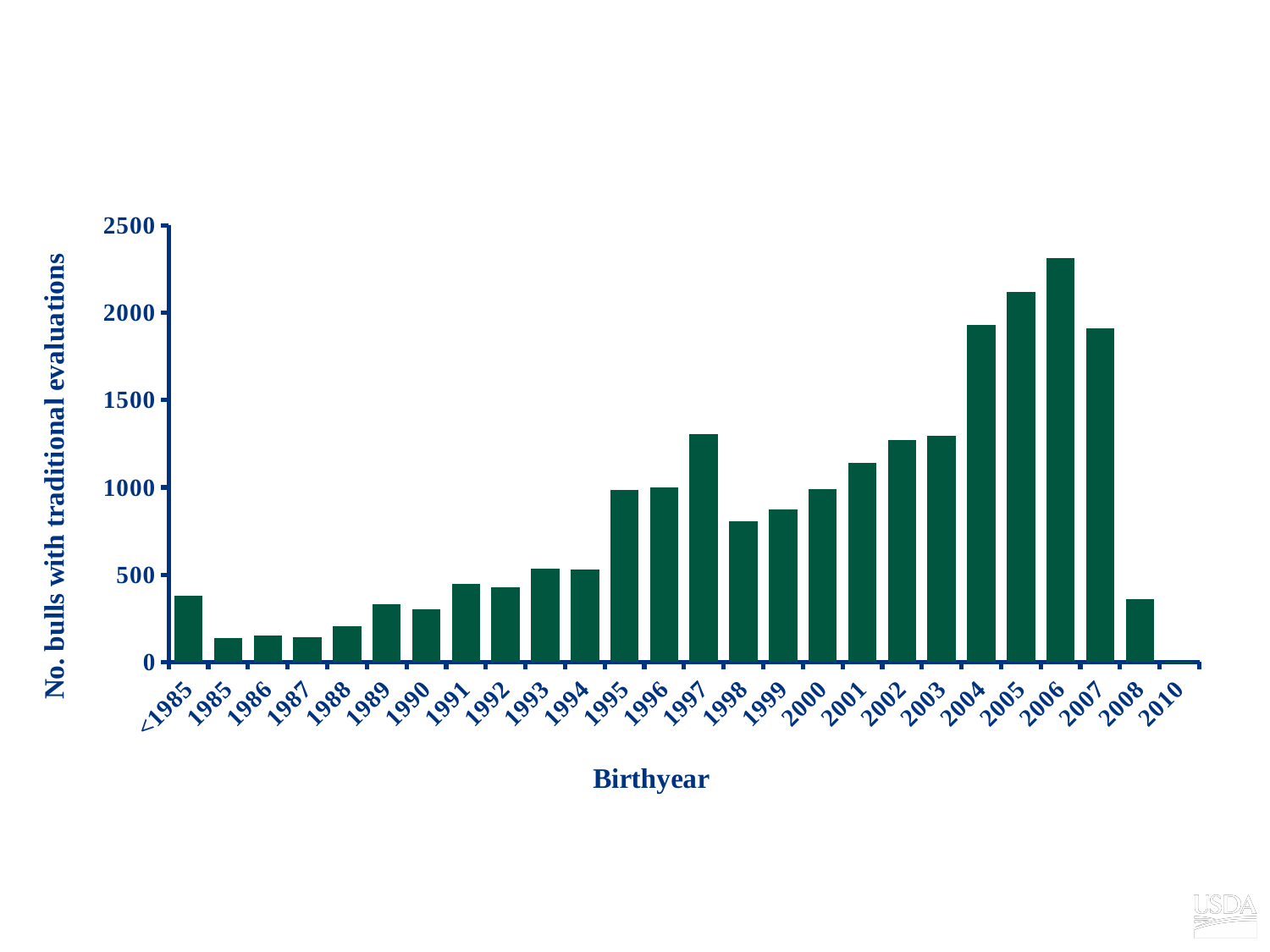
Which birthyear has the highest number of bulls with traditional evaluations? 2006 Do the values rise or fall from birthyear 2006 to birthyear 2008? fall Is the value for birthyear 2008 greater or less than 500? less Is the value for birthyear 1998 greater or less than 1000? less Which birthyear has the larger value, 2005 or 2006? 2006 Is the value for birthyear 2004 greater or less than 2000? less Which birthyear has the larger value, 1997 or 1998? 1997 What kind of chart is shown on the slide? bar chart What is the title of the x axis? Birthyear What is the title of the y axis? No. bulls with traditional evaluations